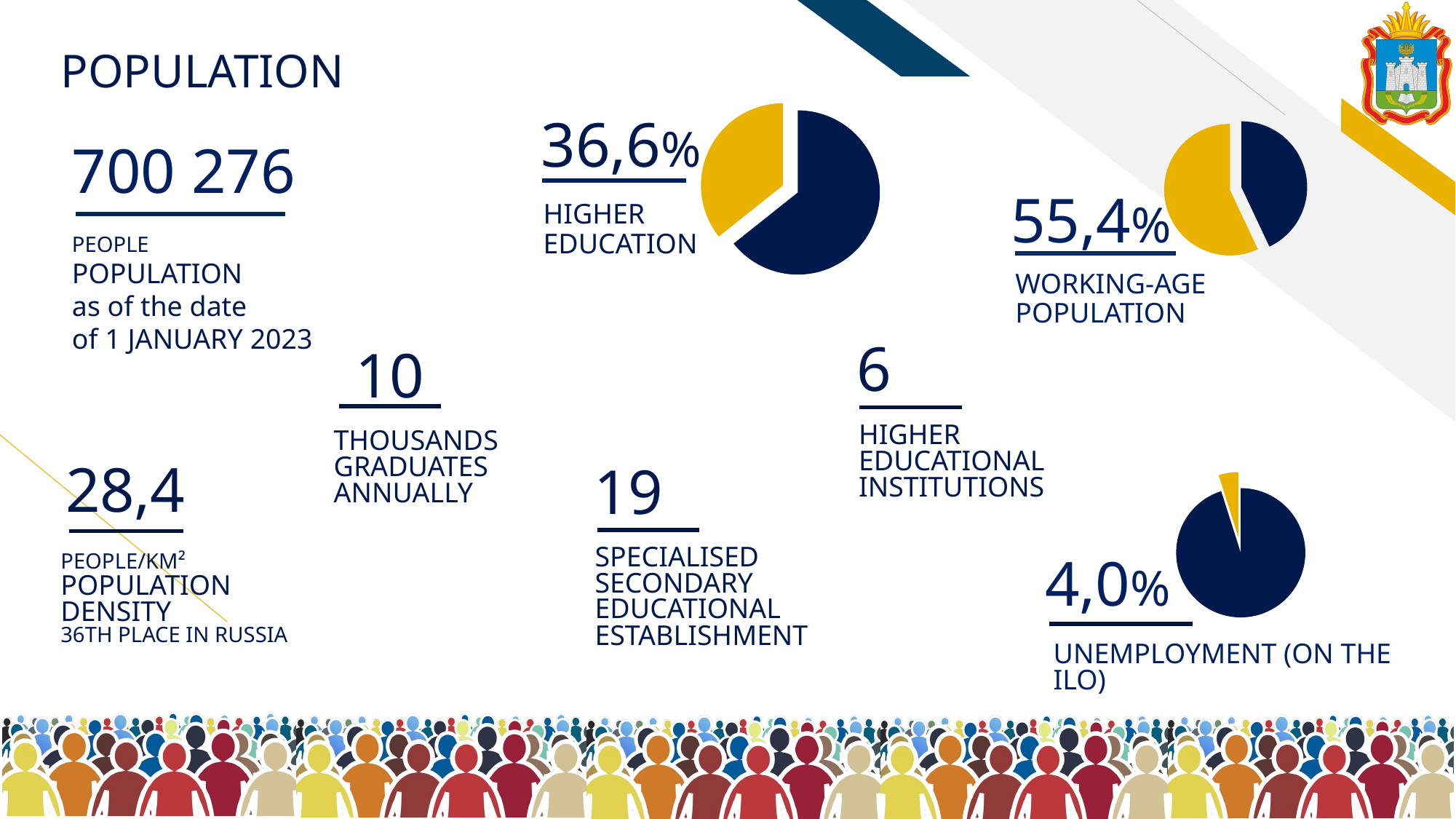
How many slices does each pie chart on the slide have? 2 In the 'HIGHER EDUCATION' pie chart, what share does the highlighted (yellow) slice represent? 36,6% Which of the three pie charts has the largest highlighted share? WORKING-AGE POPULATION In the 'UNEMPLOYMENT (ON THE ILO)' pie chart, what share does the highlighted (yellow) slice represent? 4,0% How many pie charts are shown on the slide? 3 What is the difference between the 'WORKING-AGE POPULATION' share and the 'HIGHER EDUCATION' share? 18,8 percentage points What is the difference between the 'WORKING-AGE POPULATION' share and the 'UNEMPLOYMENT (ON THE ILO)' share? 51,4 percentage points What kind of chart is used next to the 'HIGHER EDUCATION' figure? Pie chart Which of the three pie charts has the smallest highlighted share? UNEMPLOYMENT (ON THE ILO) What colour is the slice that represents the stated percentage in each pie chart? Yellow In the 'WORKING-AGE POPULATION' pie chart, what share does the highlighted (yellow) slice represent? 55,4% Which is larger: the share shown in the 'HIGHER EDUCATION' pie chart or the share shown in the 'WORKING-AGE POPULATION' pie chart? WORKING-AGE POPULATION